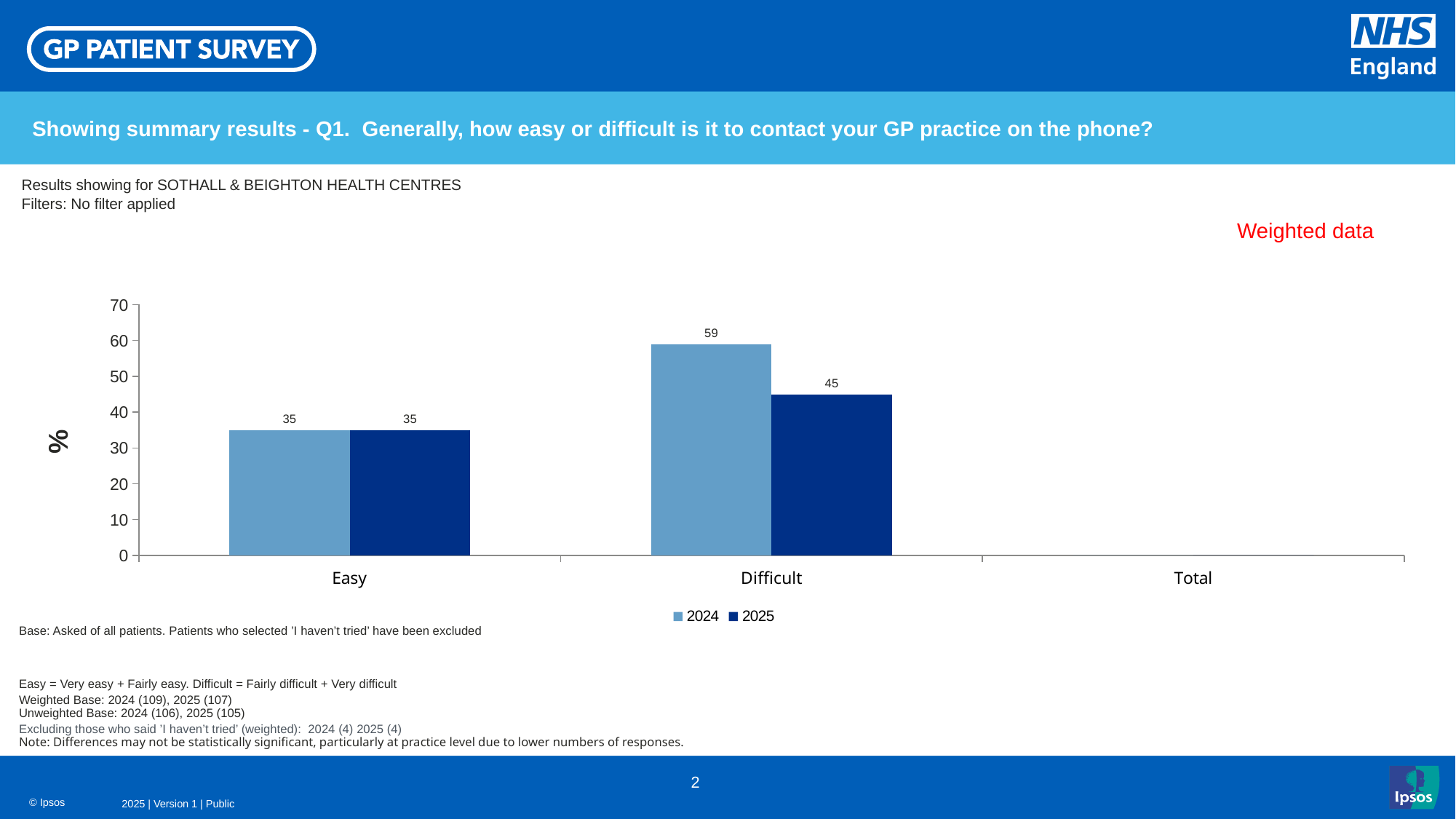
What is the value for Difficult in 2025? 45 Is the value for Difficult in 2024 greater or less than 50? greater What is the difference between the 2024 and 2025 values for Difficult? 14 Which series is shown in the darker blue colour? 2025 What kind of chart is shown on the slide? Bar chart What is the value for Easy in 2024? 35 What is the value for Difficult in 2024? 59 Which category has the lowest value for the 2025 series? Easy Which category has the highest value for the 2024 series? Difficult How many series does the legend list? 2 Which is larger for Difficult: the 2024 value or the 2025 value? 2024 What label is shown on the vertical axis? %